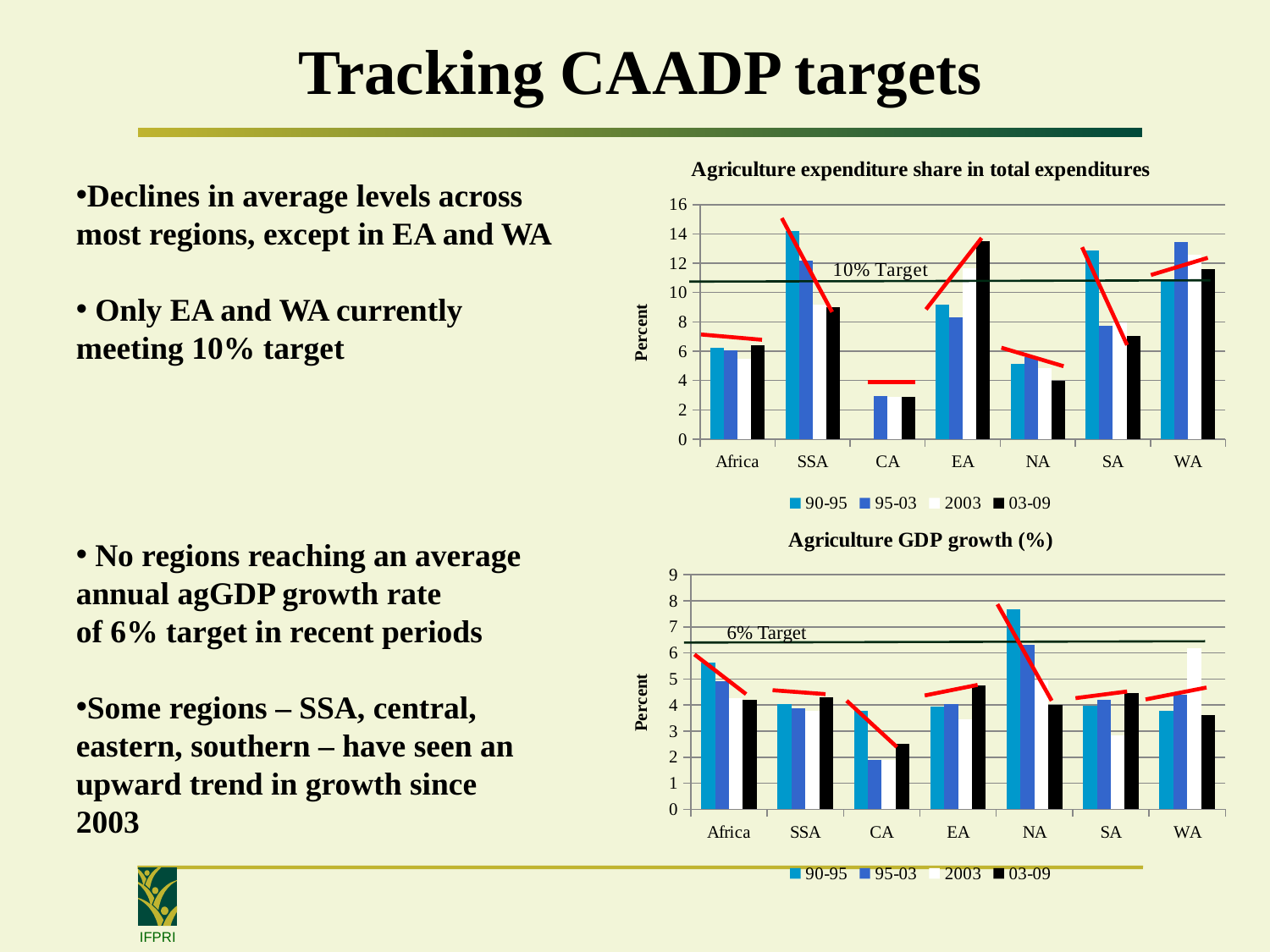
In the 'Agriculture expenditure share in total expenditures' chart, is the 03-09 value for CA greater or less than 4? less What kind of chart is the 'Agriculture expenditure share in total expenditures' chart? bar chart In the 'Agriculture expenditure share in total expenditures' chart, which is larger for the 03-09 series: EA or SSA? EA How many regions are shown on the x axis of the 'Agriculture expenditure share in total expenditures' chart? 7 In the 'Agriculture expenditure share in total expenditures' chart, which region has the highest 03-09 value? EA In the 'Agriculture GDP growth (%)' chart, is the 95-03 value for CA greater or less than 3? less In the 'Agriculture GDP growth (%)' chart, is the 90-95 value for NA greater or less than 7? greater How many regions are shown on the x axis of the 'Agriculture GDP growth (%)' chart? 7 What label is written on the horizontal target line in the 'Agriculture expenditure share in total expenditures' chart? 10% Target How many series does the legend of the 'Agriculture expenditure share in total expenditures' chart list? 4 In the 'Agriculture GDP growth (%)' chart, which region has the highest 90-95 value? NA